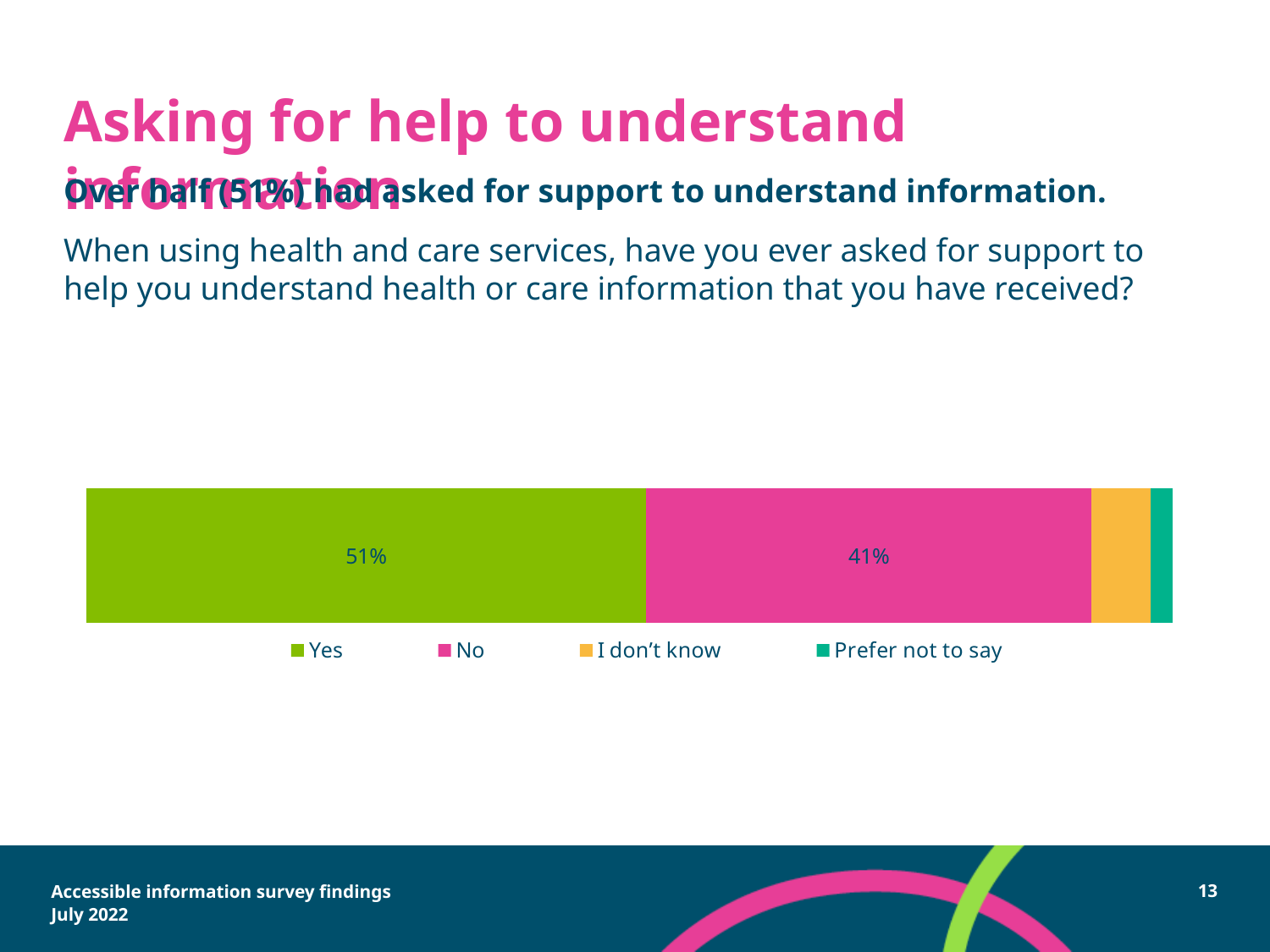
How many response categories does the legend list? 4 What kind of chart is shown on the slide? Stacked bar chart Which of the two smallest segments is larger, 'I don't know' or 'Prefer not to say'? I don't know Which response has the largest share of the bar? Yes What is the difference in percentage points between the Yes and No responses? 10 Which colour represents the 'I don't know' response in the chart? Orange Which response has the smallest share of the bar? Prefer not to say What percentage of respondents answered No? 41% What percentage of respondents answered Yes? 51% Which is larger, the share for Yes or the share for No? Yes Which colour represents the 'Prefer not to say' response in the chart? Teal